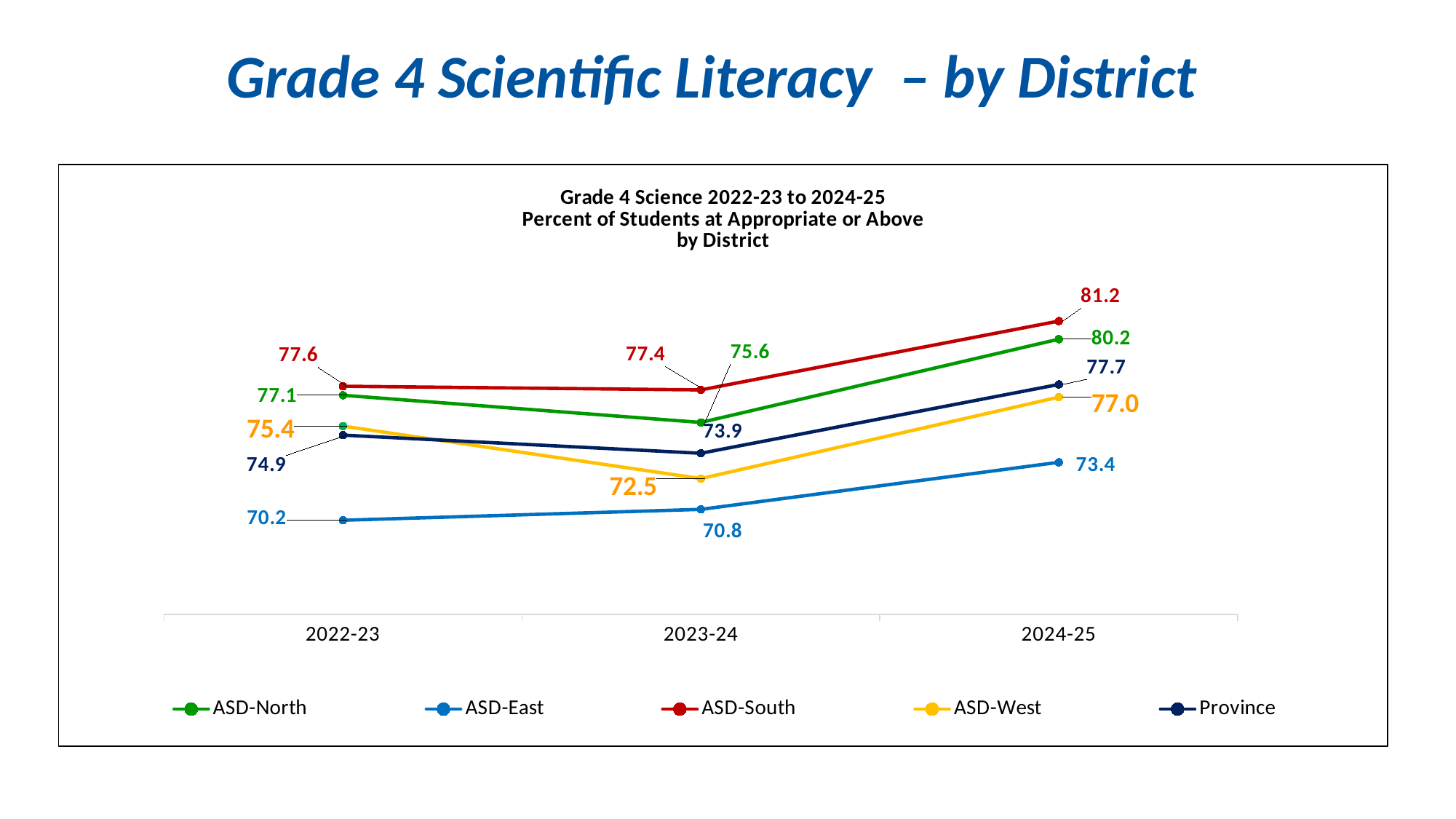
What is the value for ASD-West in 2023-24? 72.5 What is the value for ASD-South in 2024-25? 81.2 Which series has the lowest value in 2022-23? ASD-East Which is larger in 2023-24, ASD-North or Province? ASD-North What is the value for Province in 2024-25? 77.7 What is the difference between ASD-South and ASD-East in 2024-25? 7.8 How many series does the legend list? 5 What is the value for ASD-East in 2022-23? 70.2 Does the ASD-East line rise or fall from 2022-23 to 2024-25? rise What type of chart is shown on the slide? line chart Which district has the highest value in 2024-25? ASD-South How many school years are plotted along the x axis? 3